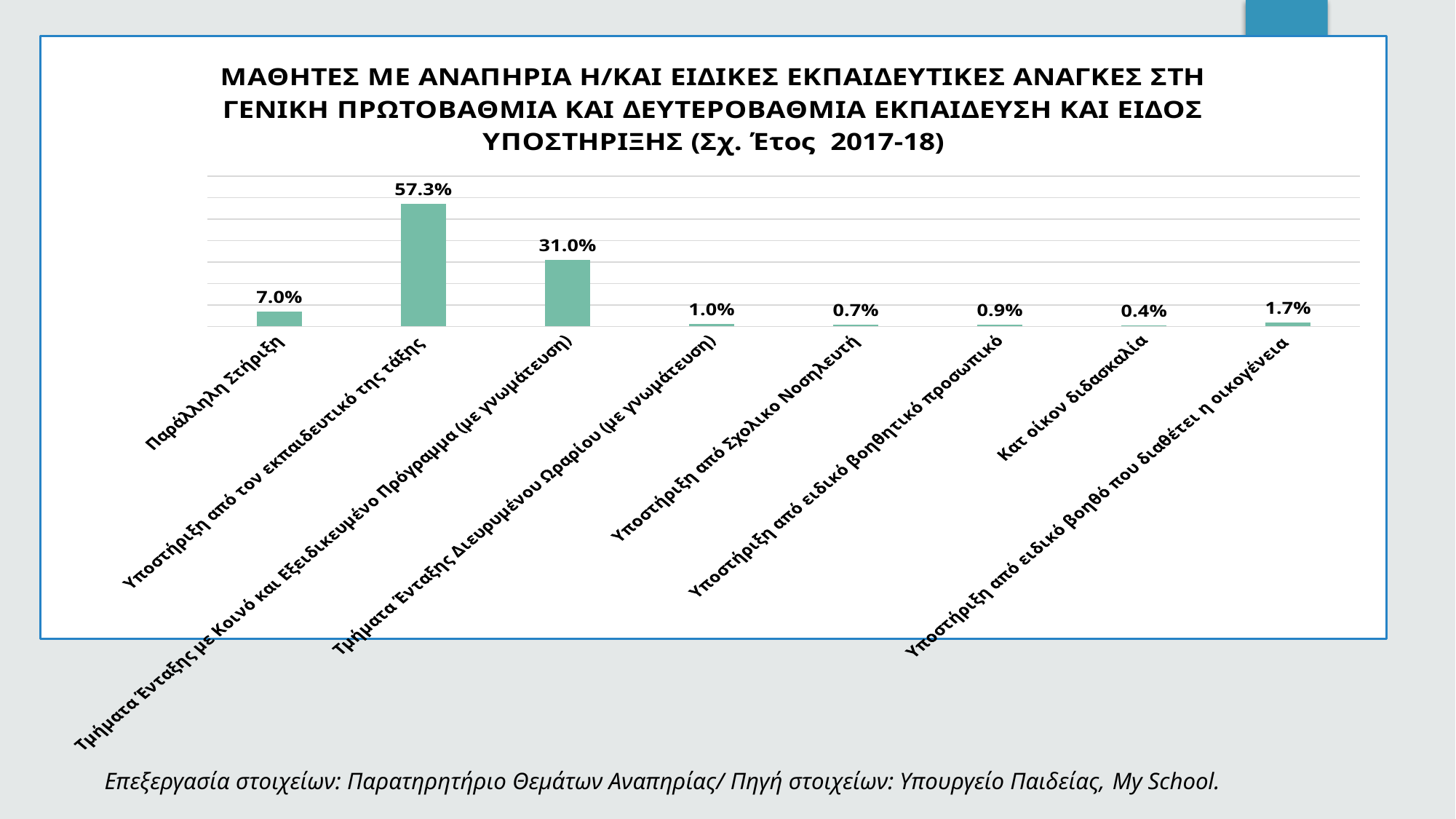
Which category has the highest value? Υποστήριξη από τον εκπαιδευτικό της τάξης What is the value for Υποστήριξη από τον εκπαιδευτικό της τάξης? 57.3% Which category has the lowest value? Κατ οίκον διδασκαλία How many categories are plotted in the chart? 8 What is the value for Παράλληλη Στήριξη? 7.0% Which is larger: the value for Υποστήριξη από Σχολικό Νοσηλευτή or the value for Υποστήριξη από ειδικό βοηθητικό προσωπικό? Υποστήριξη από ειδικό βοηθητικό προσωπικό Which school year does the chart title refer to? 2017-18 What is the value for Υποστήριξη από ειδικό βοηθό που διαθέτει η οικογένεια? 1.7% What is the value for Κατ οίκον διδασκαλία? 0.4% What kind of chart is shown on the slide? bar chart What is the value for Τμήματα Ένταξης με Κοινό και Εξειδικευμένο Πρόγραμμα (με γνωμάτευση)? 31.0% What is the difference between the values for Υποστήριξη από τον εκπαιδευτικό της τάξης and Τμήματα Ένταξης με Κοινό και Εξειδικευμένο Πρόγραμμα (με γνωμάτευση)? 26.3%